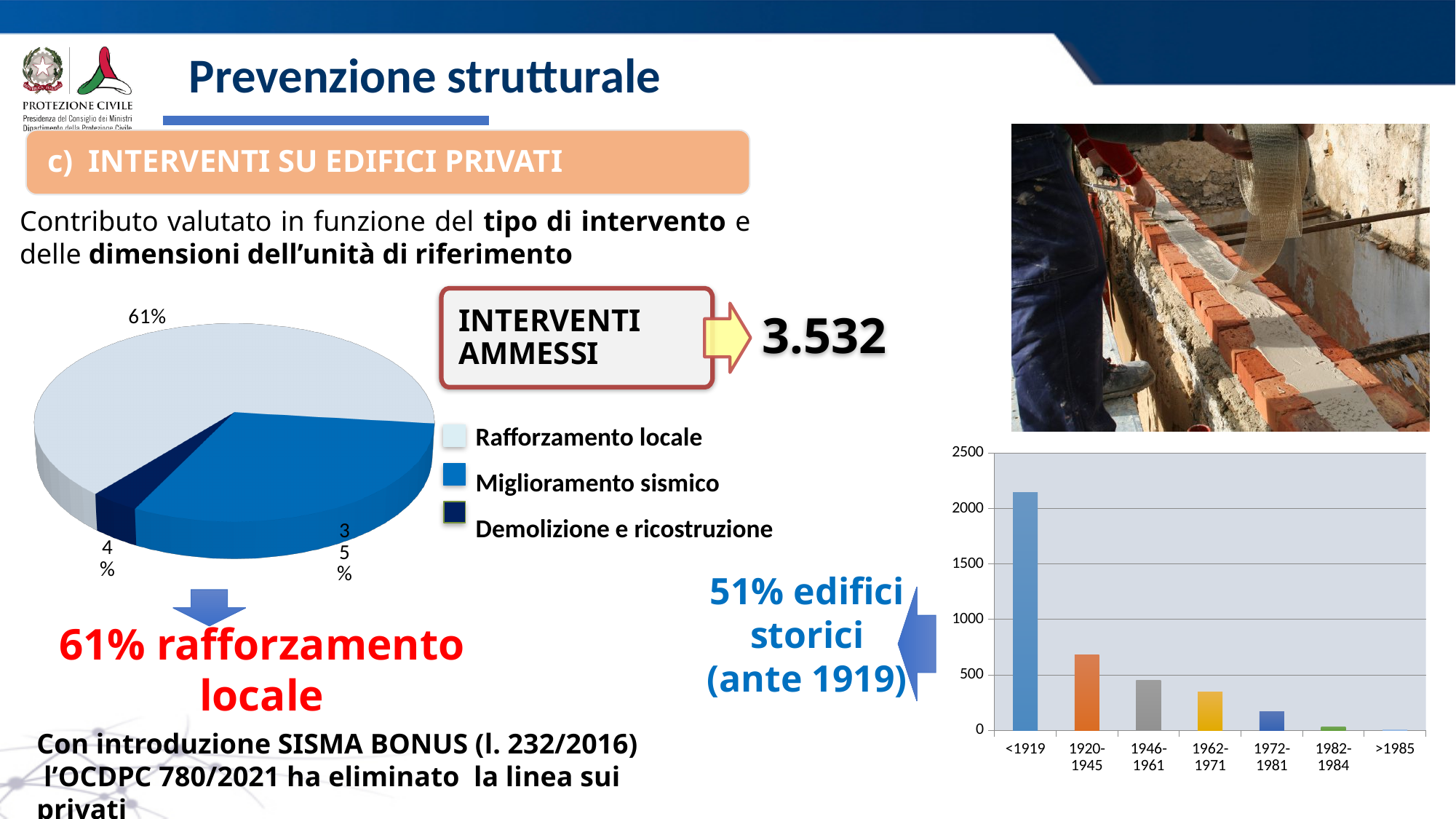
In the bar chart on the bottom right, is the value for <1919 greater or less than 2000? greater In the pie chart on the left, what share does Rafforzamento locale have? 61% In the pie chart on the left, what is the difference in percentage points between Rafforzamento locale and Miglioramento sismico? 26 What kind of chart is the chart on the bottom right of the slide? bar chart In the pie chart on the left, what share does Demolizione e ricostruzione have? 4% In the pie chart on the left, which category has the smallest slice? Demolizione e ricostruzione How many entries does the legend of the pie chart on the left list? 3 In the pie chart on the left, what share does Miglioramento sismico have? 35% In the pie chart on the left, which category has the largest slice? Rafforzamento locale In the bar chart on the bottom right, is the value for 1946-1961 greater or less than 500? less How many categories does the bar chart on the bottom right show? 7 In the bar chart on the bottom right, which category has the highest bar? <1919